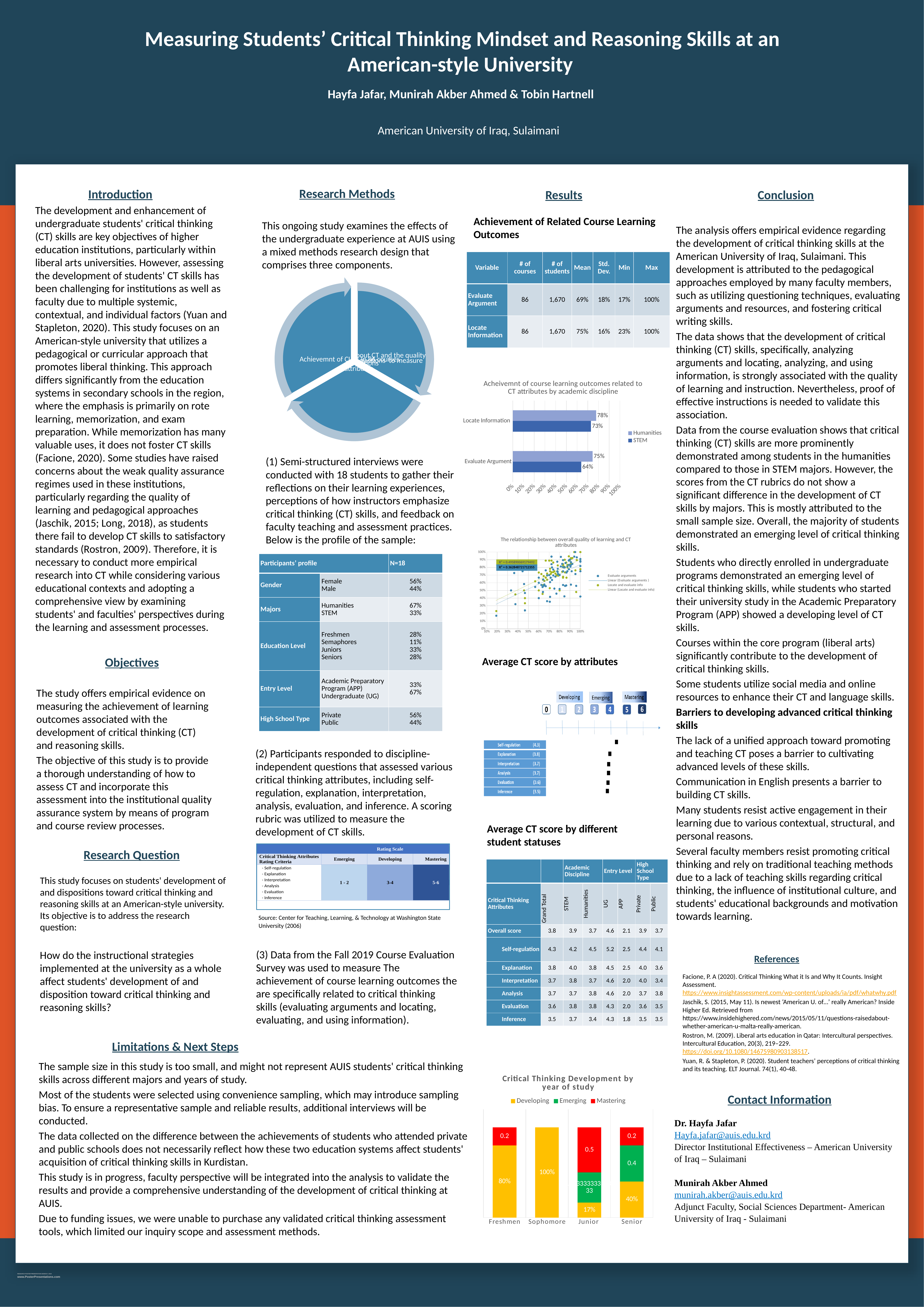
What kind of chart is 'Acheivemnt of course learning outcomes related to CT attributes by academic discipline'? Bar chart In the chart 'Acheivemnt of course learning outcomes related to CT attributes by academic discipline', which is larger for Locate Information: Humanities or STEM? Humanities In the chart 'Critical Thinking Development by year of study', which year of study has the lowest Developing value? Junior In the chart 'Acheivemnt of course learning outcomes related to CT attributes by academic discipline', what is the difference between the Humanities and STEM values for Evaluate Argument? 11% In the chart 'Critical Thinking Development by year of study', how many year-of-study categories are shown on the x axis? 4 In the chart 'Acheivemnt of course learning outcomes related to CT attributes by academic discipline', how many series does the legend list? 2 In the chart 'Acheivemnt of course learning outcomes related to CT attributes by academic discipline', what is the Humanities value for Locate Information? 78% In the chart 'Acheivemnt of course learning outcomes related to CT attributes by academic discipline', what is the STEM value for Evaluate Argument? 64% In the chart 'Critical Thinking Development by year of study', which series does the legend list first? Developing In the chart 'Critical Thinking Development by year of study', what is the Mastering value for Junior? 0.5 In the chart 'Critical Thinking Development by year of study', what is the Developing value for Sophomore? 100% In the chart 'Critical Thinking Development by year of study', what is the Emerging value for Senior? 0.4